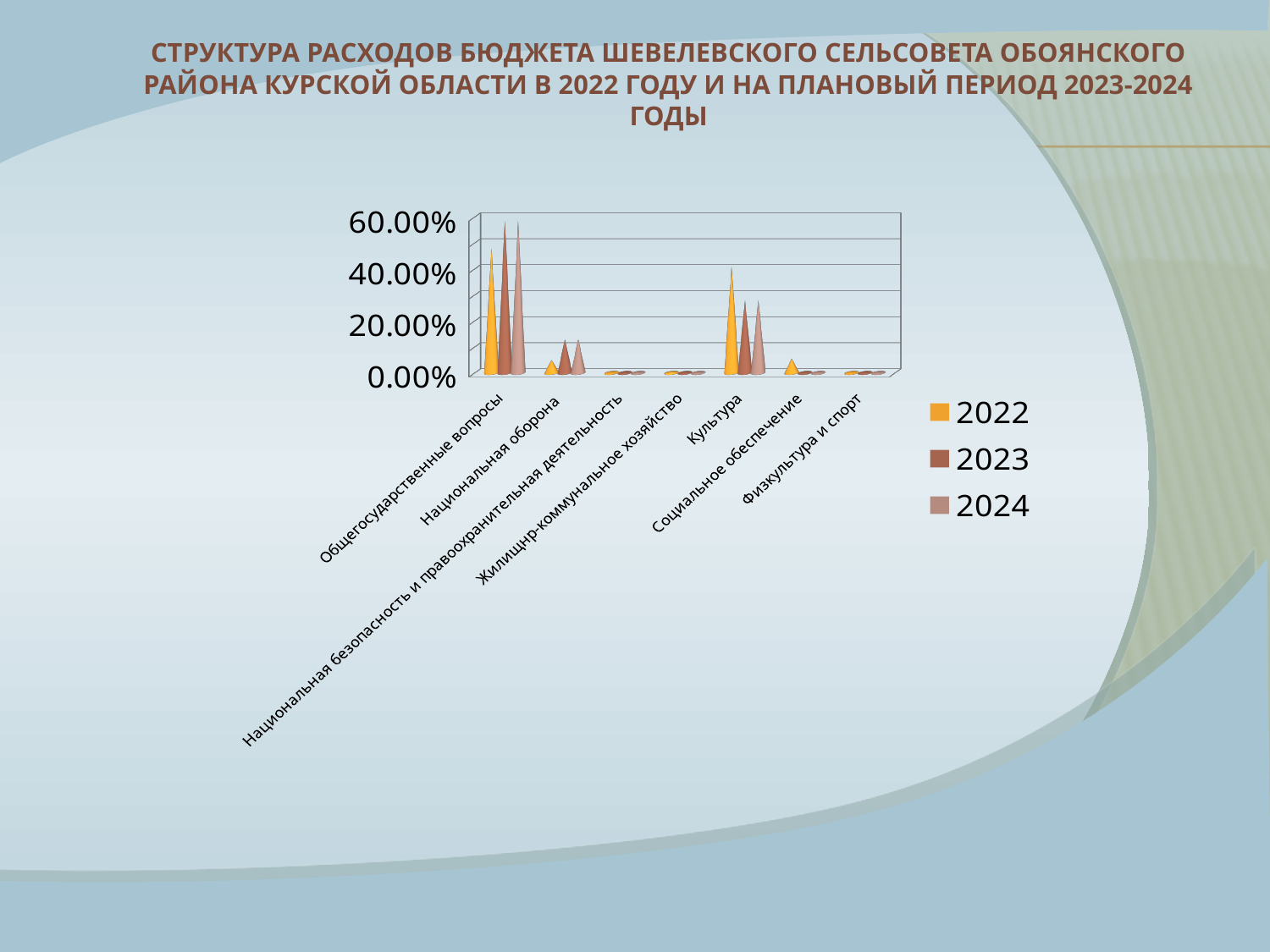
For the 2022 series, which is larger: Общегосударственные вопросы or Культура? Общегосударственные вопросы How many categories are shown on the x axis of the chart? 7 For Культура, which year has the larger value: 2022 or 2023? 2022 What kind of chart is shown on the slide? bar chart Is the value for Общегосударственные вопросы in 2023 greater or less than 40.00%? greater Is the value for Социальное обеспечение in 2022 greater or less than 20.00%? less How many series does the chart legend list? 3 Is the value for Культура in 2022 greater or less than 20.00%? greater Which category has the highest value for the 2023 series? Общегосударственные вопросы Which category has the highest value for the 2022 series? Общегосударственные вопросы Which years are listed in the chart legend? 2022, 2023, 2024